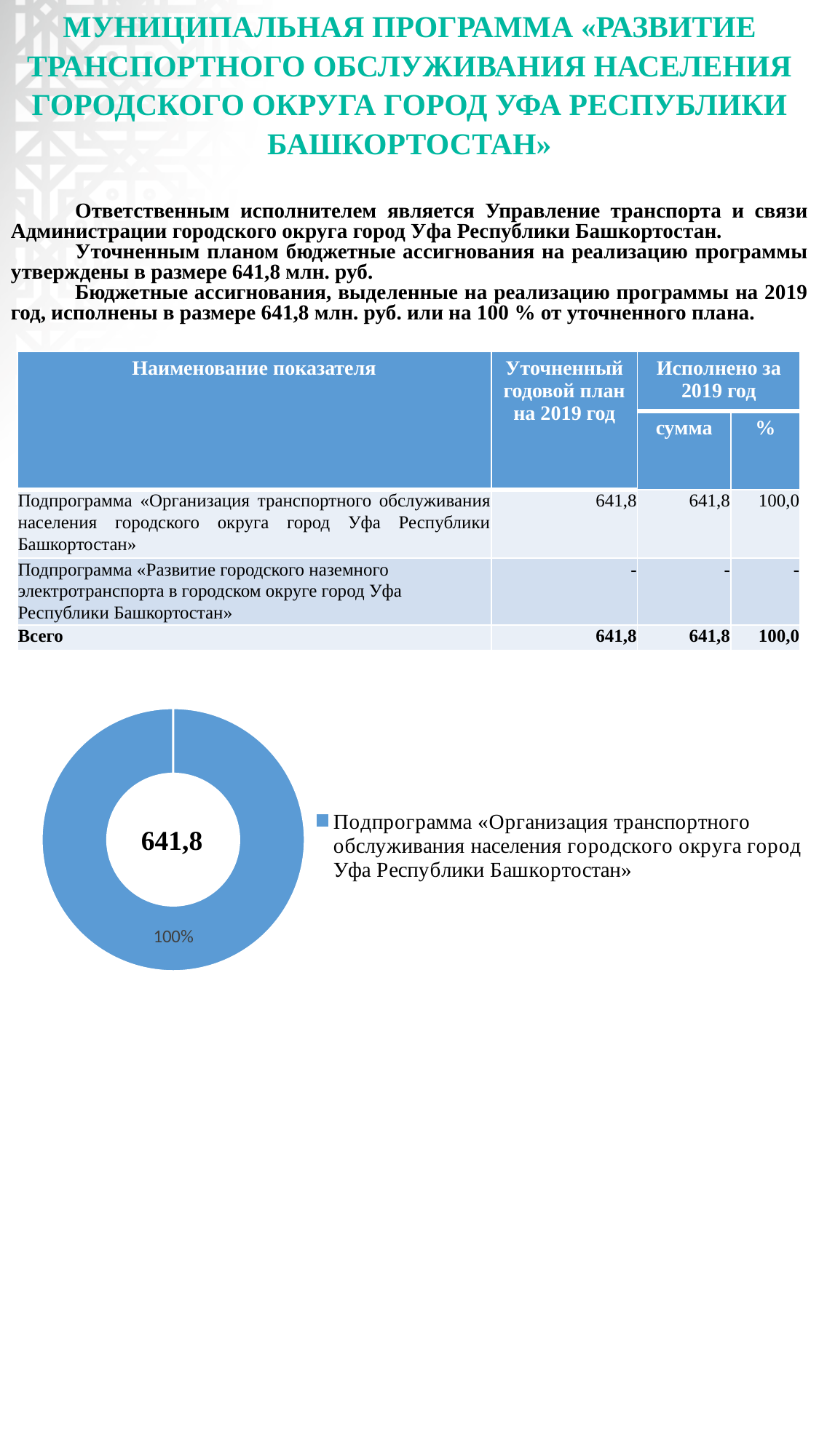
How many entries does the legend of the doughnut chart list? 1 How many slices does the doughnut chart contain? 1 What share of the doughnut chart does the slice for «Подпрограмма «Организация транспортного обслуживания населения городского округа город Уфа Республики Башкортостан»» represent? 100% What kind of chart is shown on the slide? Doughnut (pie) chart Is the share shown on the doughnut chart slice greater or less than 50%? greater What colour is the slice in the doughnut chart? Blue What value is printed in the centre of the doughnut chart? 641,8 What is the legend entry of the doughnut chart? Подпрограмма «Организация транспортного обслуживания населения городского округа город Уфа Республики Башкортостан»